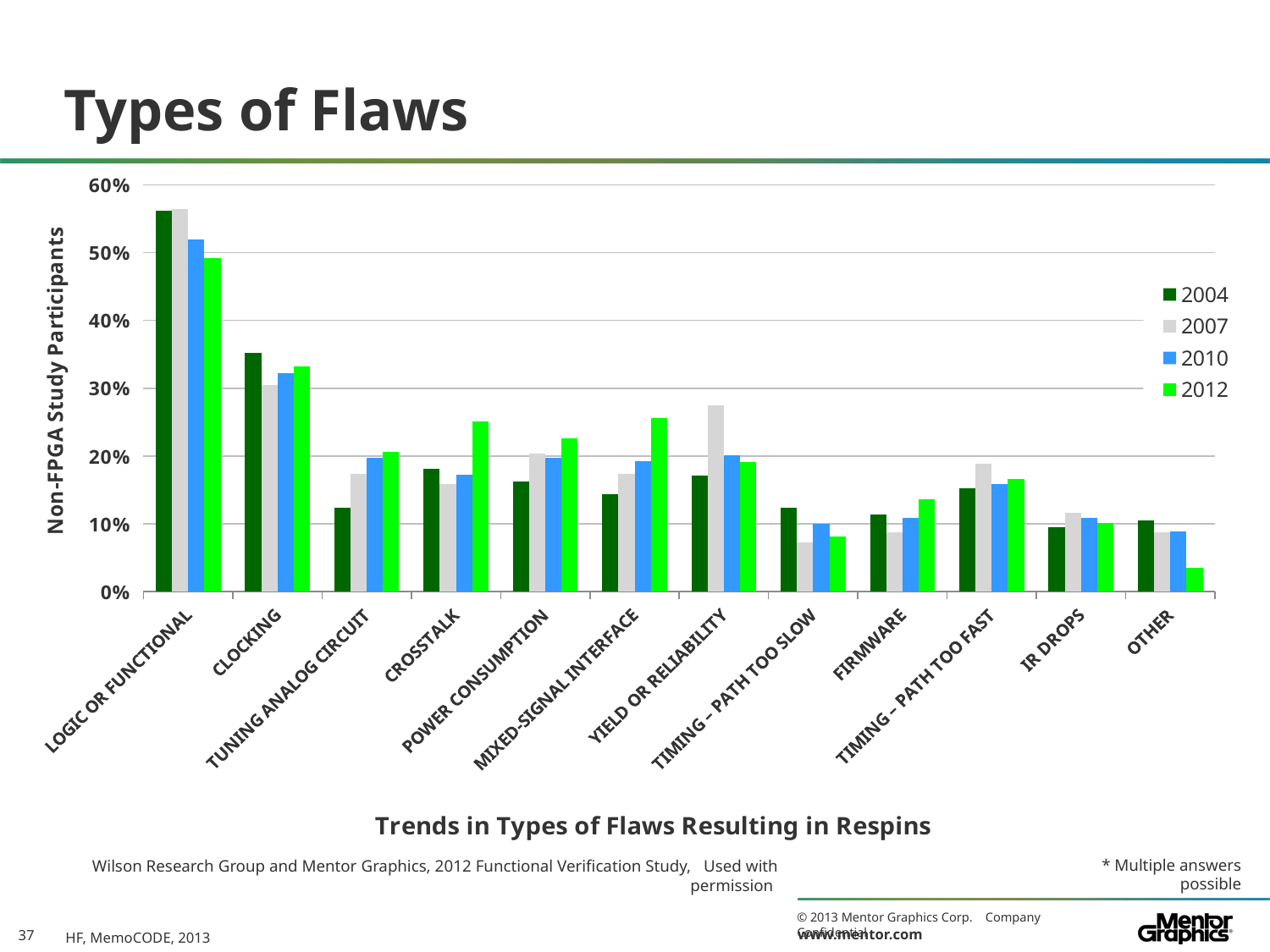
For Crosstalk, which series has the larger value, 2004 or 2012? 2012 Is the 2004 value for Logic or Functional greater or less than 50%? greater For Yield or Reliability, which series has the larger value, 2004 or 2007? 2007 Is the 2012 value for Other greater or less than 10%? less Which category has the lowest value for the 2012 series? Other For Tuning Analog Circuit, do the values rise or fall from the 2004 series to the 2012 series? rise How many series does the legend list? 4 Is the 2012 value for Clocking greater or less than 30%? greater How many flaw categories are shown along the x axis? 12 Which category has the highest value for the 2012 series? Logic or Functional What is the title of the chart? Trends in Types of Flaws Resulting in Respins What kind of chart is shown on the slide? Bar chart